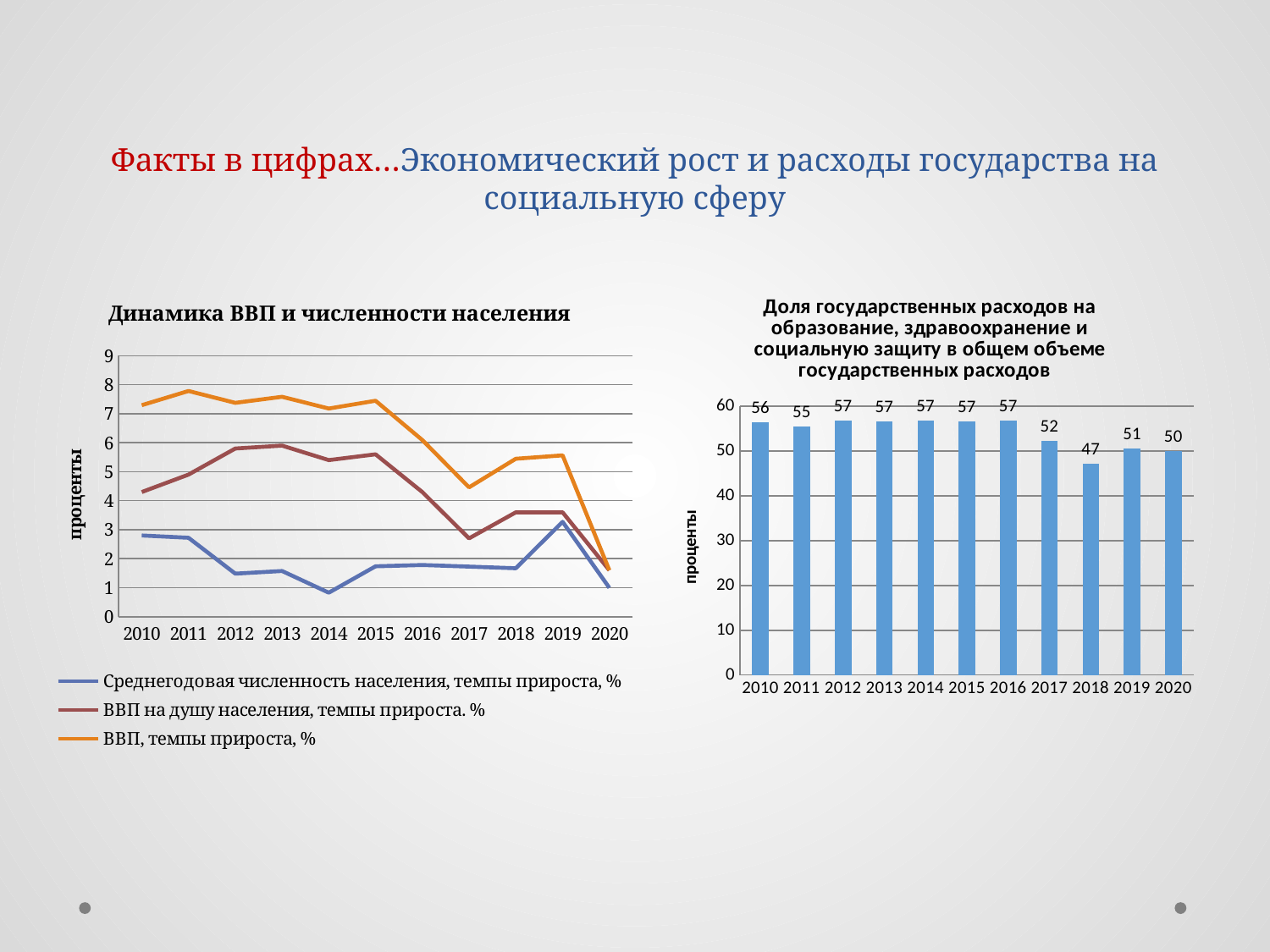
In the chart 'Динамика ВВП и численности населения', which series is shown in orange? ВВП, темпы прироста, % In the chart 'Доля государственных расходов на образование, здравоохранение и социальную защиту в общем объеме государственных расходов', how many years are shown on the x axis? 11 In the chart 'Доля государственных расходов на образование, здравоохранение и социальную защиту в общем объеме государственных расходов', which is larger, the value for 2019 or the value for 2020? 2019 In the chart 'Динамика ВВП и численности населения', is the value of 'Среднегодовая численность населения, темпы прироста, %' for 2014 greater or less than 1? less In the chart 'Динамика ВВП и численности населения', is the value of 'ВВП, темпы прироста, %' for 2011 greater or less than 7? greater In the chart 'Доля государственных расходов на образование, здравоохранение и социальную защиту в общем объеме государственных расходов', which year has the lowest value? 2018 What kind of chart is the chart on the right of the slide? bar chart In the chart 'Доля государственных расходов на образование, здравоохранение и социальную защиту в общем объеме государственных расходов', what is the value for 2010? 56 How many series does the legend of 'Динамика ВВП и численности населения' list? 3 What kind of chart is 'Динамика ВВП и численности населения'? line chart In the chart 'Доля государственных расходов на образование, здравоохранение и социальную защиту в общем объеме государственных расходов', what is the difference between the values for 2017 and 2018? 5 In the chart 'Доля государственных расходов на образование, здравоохранение и социальную защиту в общем объеме государственных расходов', what is the value for 2018? 47